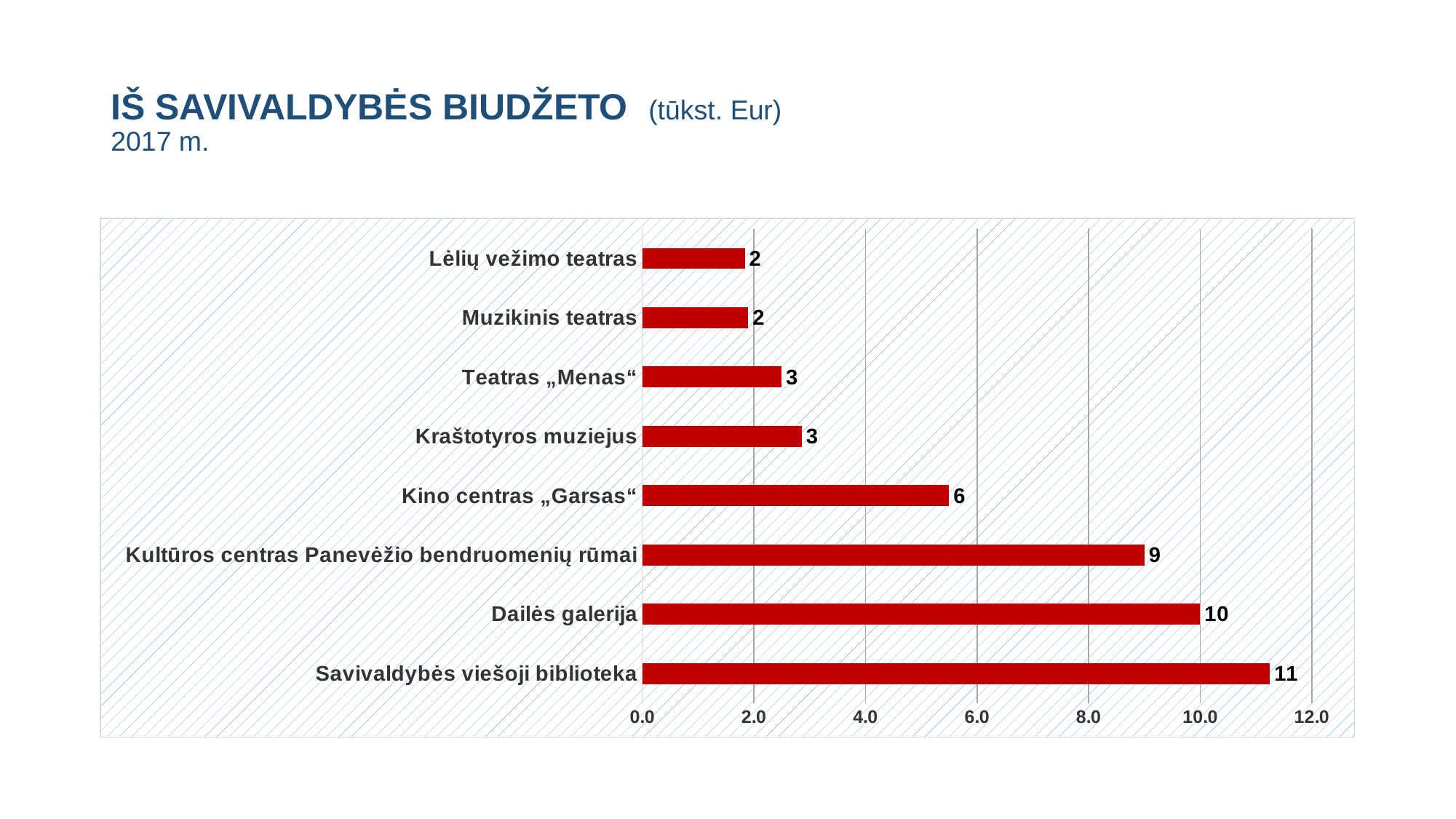
What unit is given in the chart title? tūkst. Eur Is the value for Kino centras „Garsas“ greater or less than 4.0? greater Which is larger, the value for Kultūros centras Panevėžio bendruomenių rūmai or the value for Kino centras „Garsas“? Kultūros centras Panevėžio bendruomenių rūmai What is the difference between the values for Savivaldybės viešoji biblioteka and Dailės galerija? 1 What is the value for Dailės galerija? 10 What kind of chart is shown on the slide? bar chart Which category has the highest value? Savivaldybės viešoji biblioteka What is the value for Kino centras „Garsas“? 6 What is the value for Savivaldybės viešoji biblioteka? 11 What is the difference between the values for Dailės galerija and Kino centras „Garsas“? 4 How many categories are shown in the chart? 8 What is the value for Kultūros centras Panevėžio bendruomenių rūmai? 9